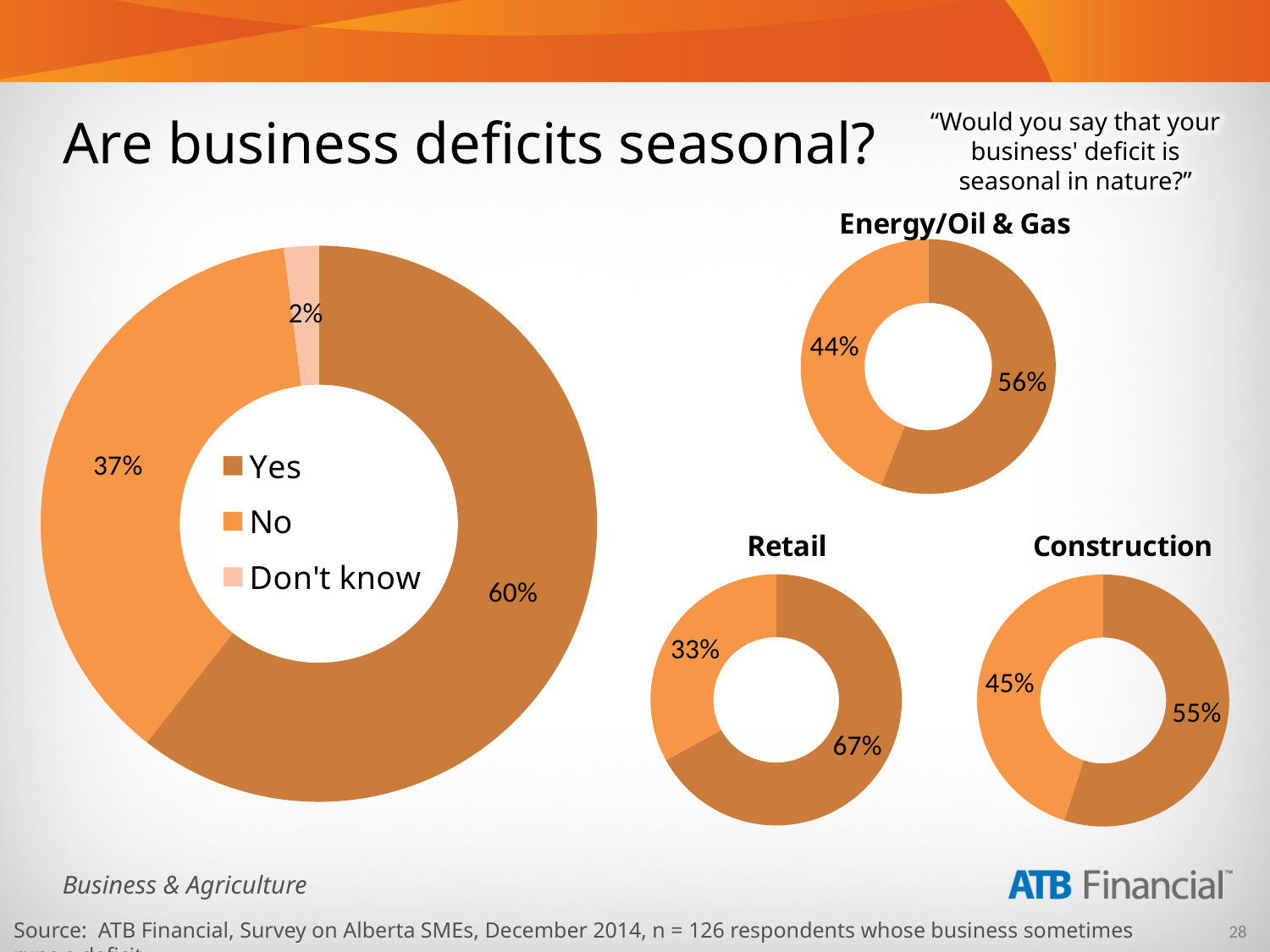
In the Construction chart, what percentage is shown for the darker orange ("Yes") segment? 55% Which industry chart shows the highest "Yes" percentage: Energy/Oil & Gas, Retail, or Construction? Retail In the large donut chart on the left, what percentage of respondents answered "Yes"? 60% In the large donut chart on the left, which response has the smallest share? Don't know How many entries does the legend in the large donut chart on the left list? 3 In the Retail chart, what percentage is shown for the lighter orange ("No") segment? 33% In the large donut chart on the left, what percentage of respondents answered "Don't know"? 2% What kind of chart is used on this slide? Donut (pie) chart In the large donut chart on the left, what is the difference in percentage points between the "Yes" and "No" shares? 23 In the large donut chart on the left, what percentage of respondents answered "No"? 37% How many small industry donut charts are shown on the right side of the slide? 3 In the Energy/Oil & Gas chart, what is the larger of the two percentages shown? 56%